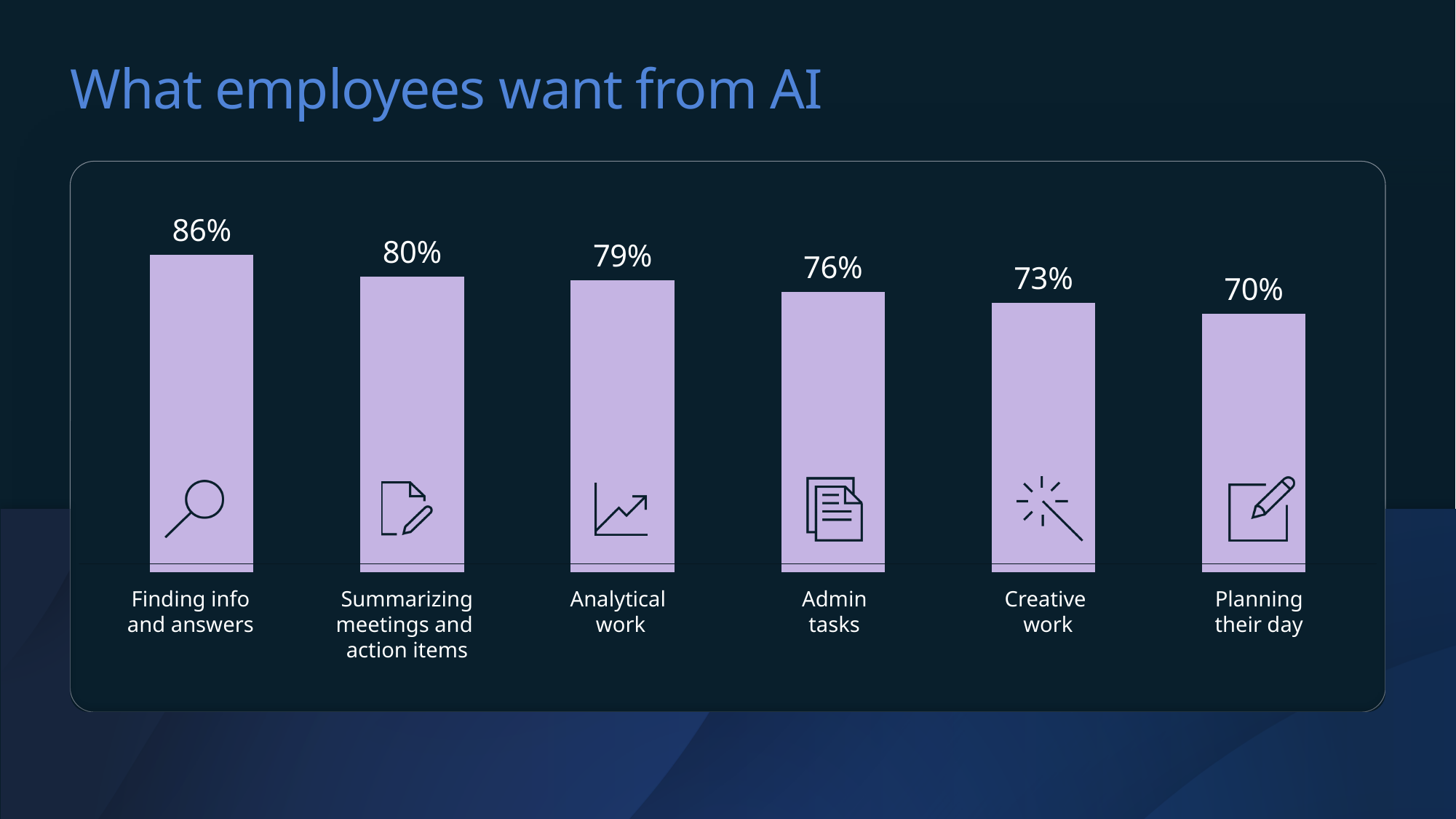
What is the value shown for summarizing meetings and action items? 80% What percentage is shown for analytical work? 79% What kind of chart is shown on the slide? Bar chart What is the difference between the values for finding info and answers and creative work? 13% What percentage is shown for planning their day? 70% Which category has the lowest value? Planning their day Do the values rise or fall from left to right across the chart? Fall What is the value for admin tasks? 76% What percentage of employees want AI for finding info and answers? 86% Which is larger, the value for admin tasks or the value for creative work? Admin tasks Which category has the highest value? Finding info and answers How many categories are shown in the chart? 6